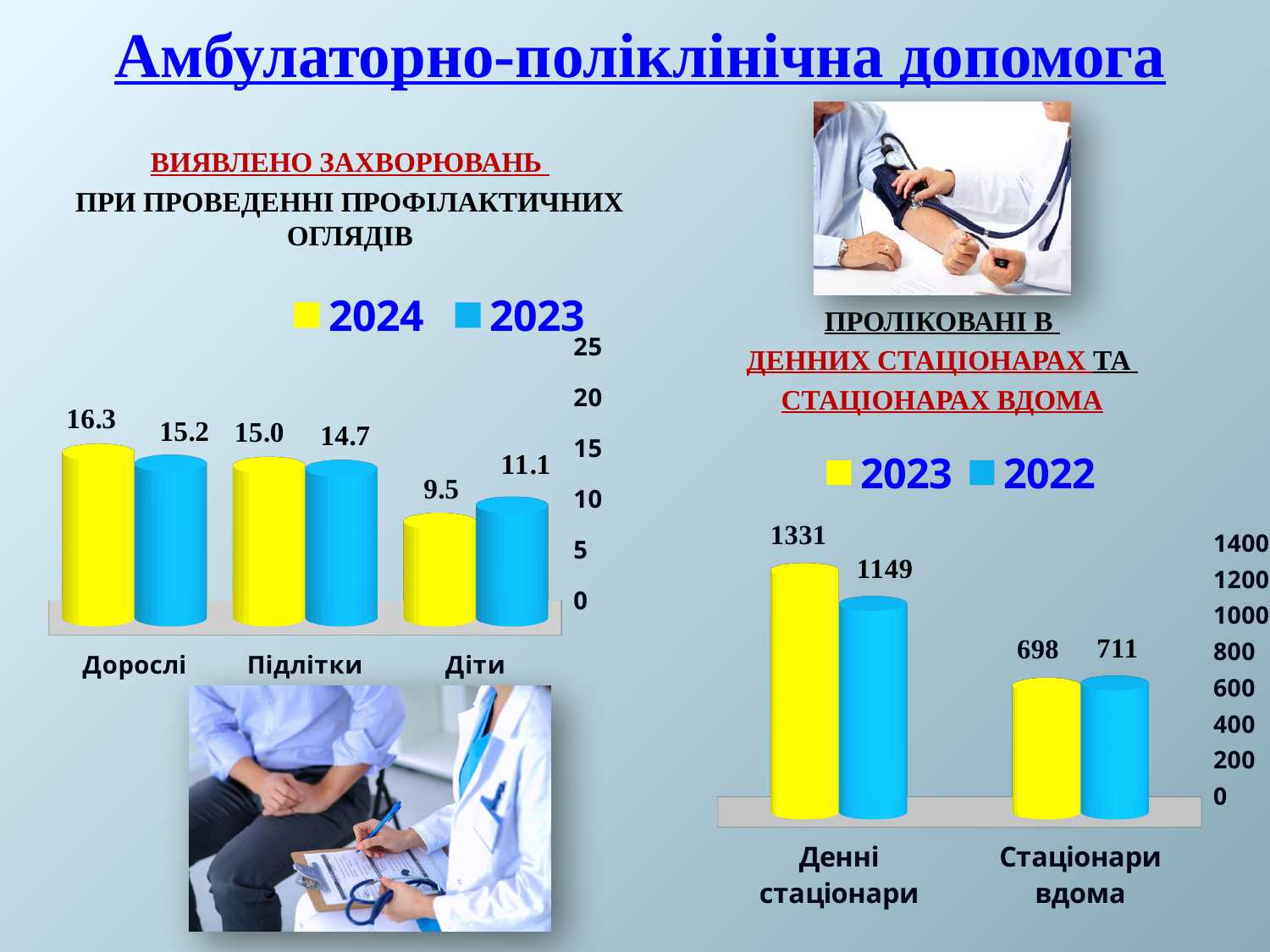
In the left chart (Виявлено захворювань при проведенні профілактичних оглядів), what is the 2024 value for Дорослі? 16.3 In the right chart, what is the 2022 value for Стаціонари вдома? 711 What type of chart is the right chart? Bar chart In the right chart, what is the difference between the 2023 and 2022 values for Денні стаціонари? 182 In the left chart, for Діти, which series is larger: 2024 or 2023? 2023 In the left chart, what is the 2023 value for Діти? 11.1 In the left chart, what is the difference between the 2024 and 2023 values for Дорослі? 1.1 In the left chart, which category has the lowest 2024 value? Діти In the right chart, which category has the highest value across both series? Денні стаціонари In the left chart, how many categories are shown on the x axis? 3 In the right chart (Проліковані в денних стаціонарах та стаціонарах вдома), what is the 2023 value for Денні стаціонари? 1331 In the left chart, how many series does the legend list? 2